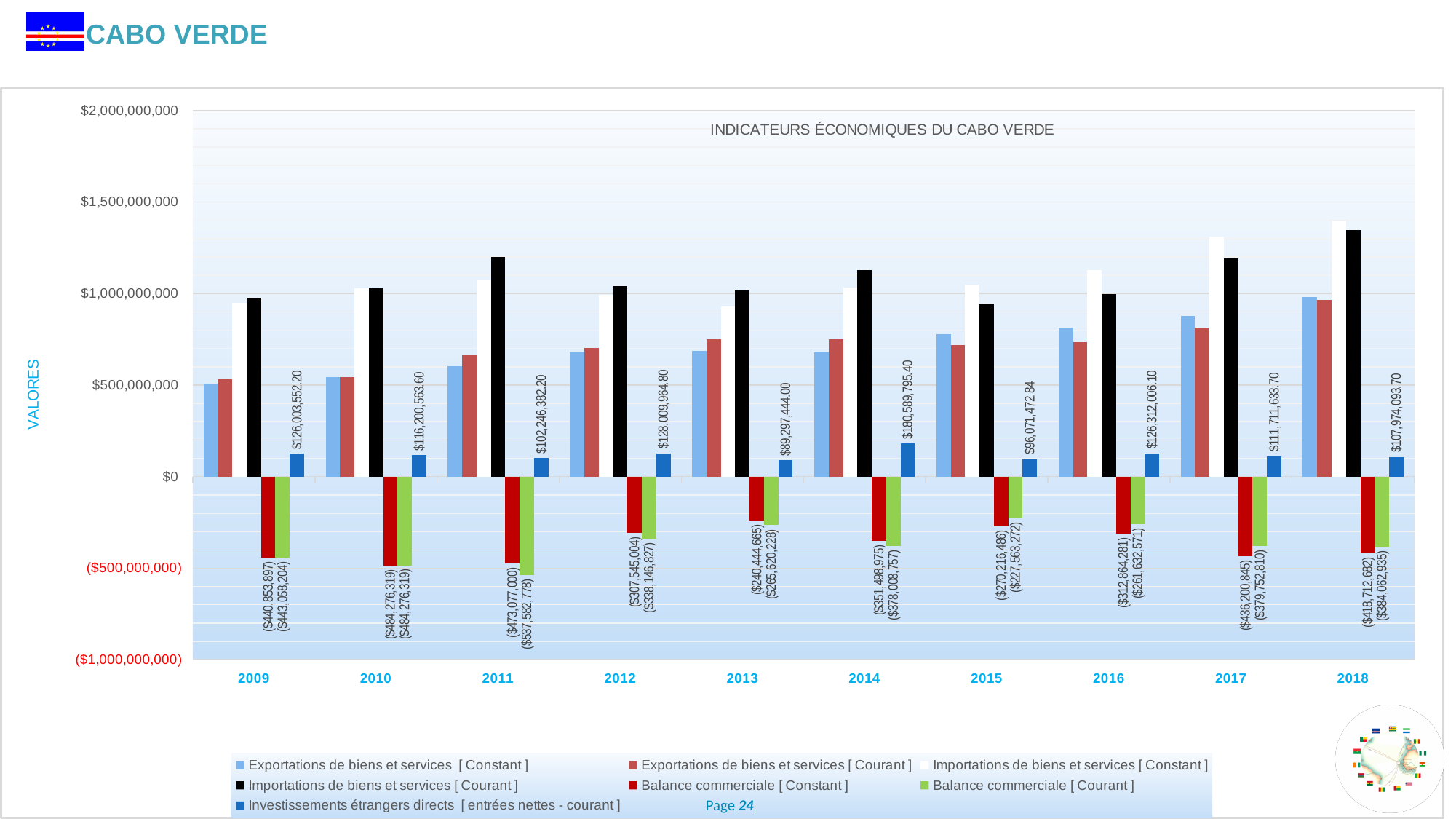
What is the value of Balance commerciale [Courant] in 2011? ($537,582,778) What is the title of the chart? INDICATEURS ÉCONOMIQUES DU CABO VERDE What type of chart is shown on the slide? bar chart How many series does the legend list? 7 How many years are shown on the x axis? 10 In which year is Investissements étrangers directs the highest? 2014 What is the difference between Investissements étrangers directs in 2014 and in 2013? $91,292,351.40 Which year has the larger value of Investissements étrangers directs, 2011 or 2012? 2012 What is the value of Balance commerciale [Constant] in 2016? ($312,864,281) Is the value of Importations de biens et services [Courant] in 2018 greater or less than $1,000,000,000? greater What is the value of Investissements étrangers directs in 2014? $180,589,795.40 In which year is Investissements étrangers directs the lowest? 2013